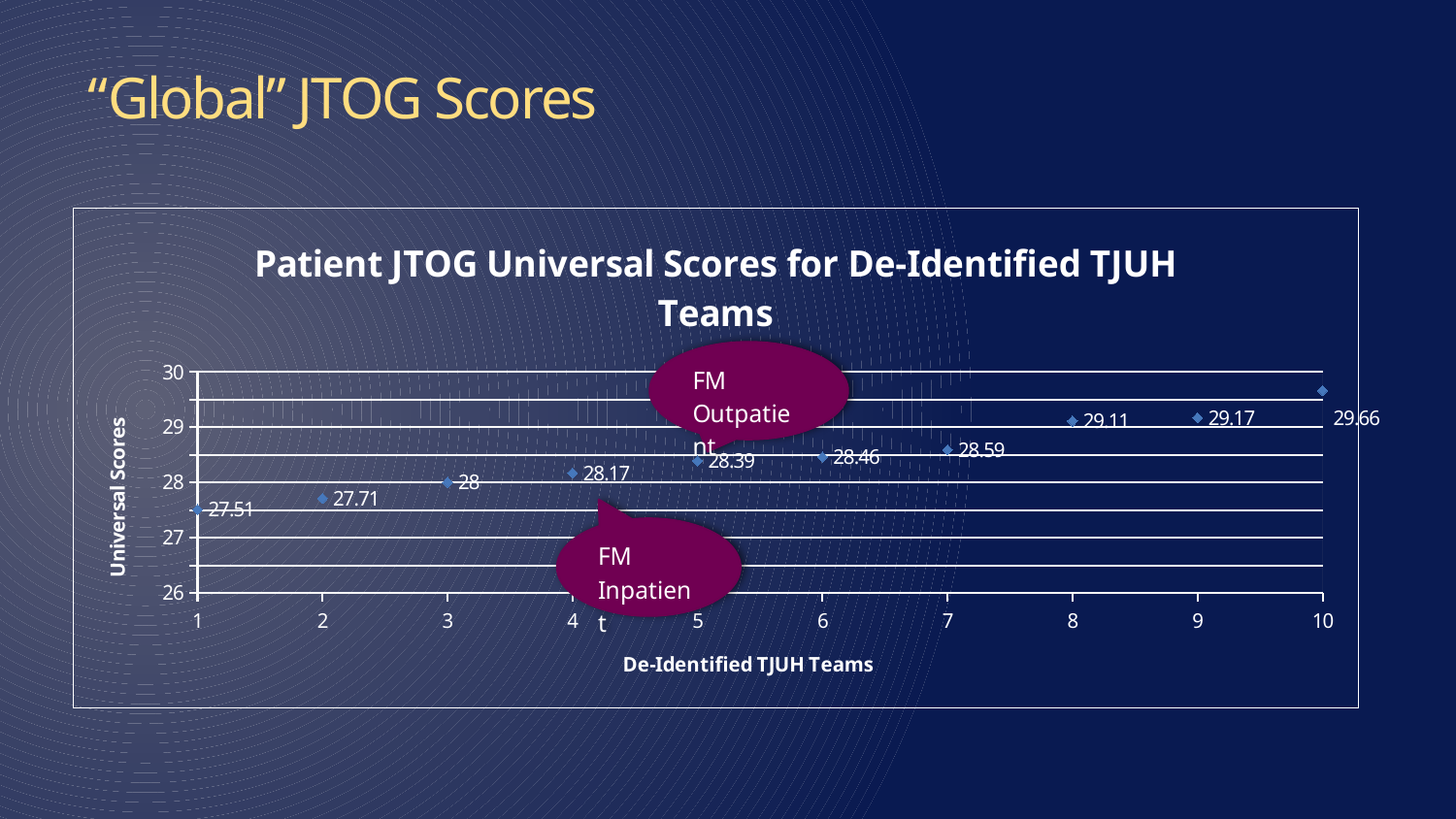
Which has a higher Universal Score, team 3 or team 7? Team 7 What is the title of the chart? Patient JTOG Universal Scores for De-Identified TJUH Teams Which team has the lowest Universal Score? 1 How many teams are plotted on the chart? 10 What is the difference between the Universal Scores of team 10 and team 1? 2.15 Is the Universal Score for team 9 greater or less than 29? greater What kind of chart is shown on the slide? Scatter chart What is the Universal Score for team 5? 28.39 What is the Universal Score for team 8? 29.11 Which team has the highest Universal Score? 10 What is the Universal Score for team 1? 27.51 Do the Universal Scores rise or fall as the team number increases from 1 to 10? Rise